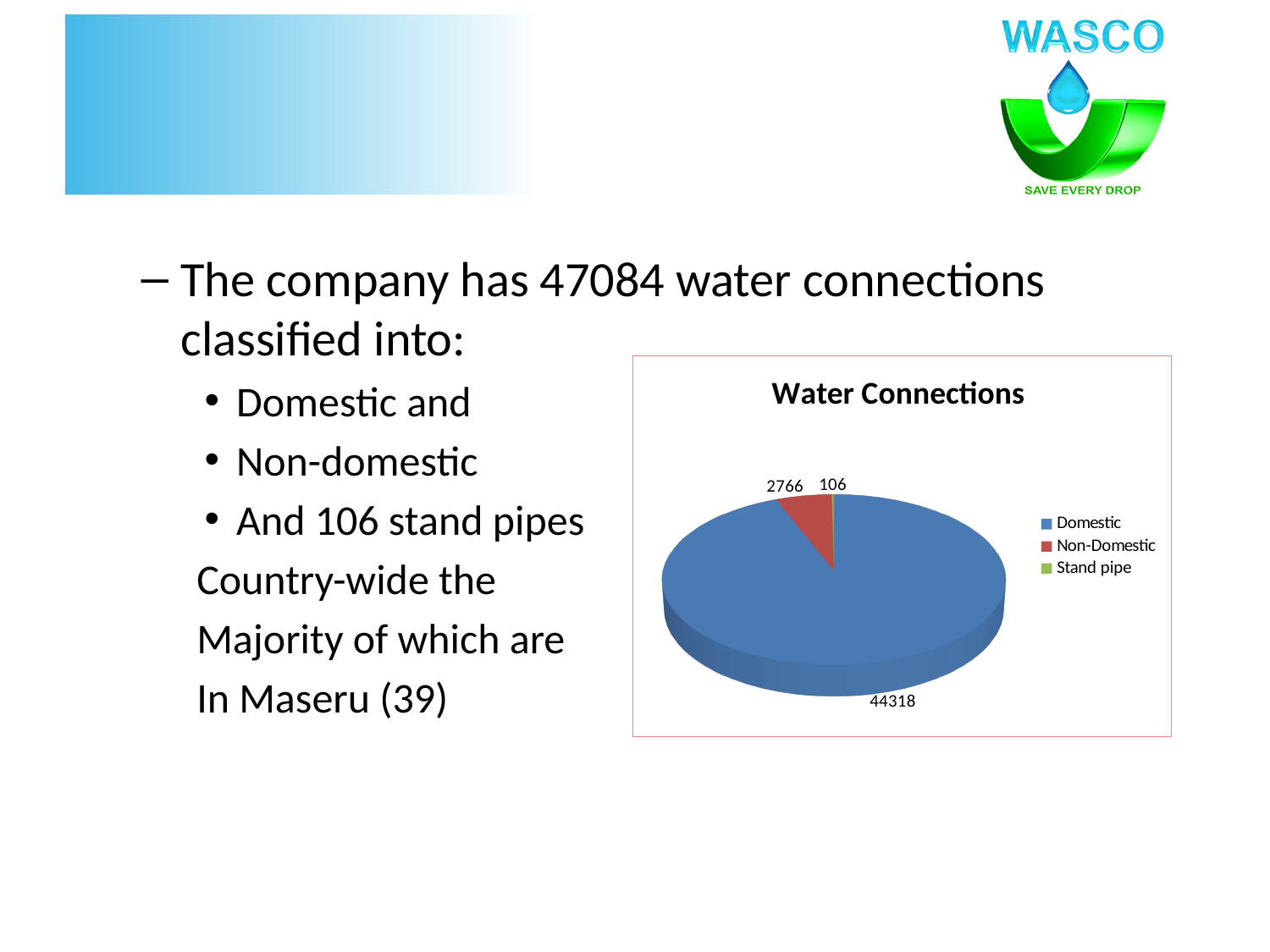
Which is larger in the Water Connections chart, Non-Domestic or Stand pipe? Non-Domestic What is the value for Stand pipe in the Water Connections chart? 106 How many entries does the legend of the Water Connections chart list? 3 Which category has the largest slice in the Water Connections chart? Domestic Which category has the smallest slice in the Water Connections chart? Stand pipe What type of chart is shown on the slide? Pie chart What is the value for Non-Domestic in the Water Connections chart? 2766 What colour is the Domestic slice in the Water Connections chart? Blue What is the value for Domestic in the Water Connections chart? 44318 What is the difference between the Domestic and Non-Domestic values in the Water Connections chart? 41552 What is the title of the chart? Water Connections How many slices does the Water Connections pie chart have? 3